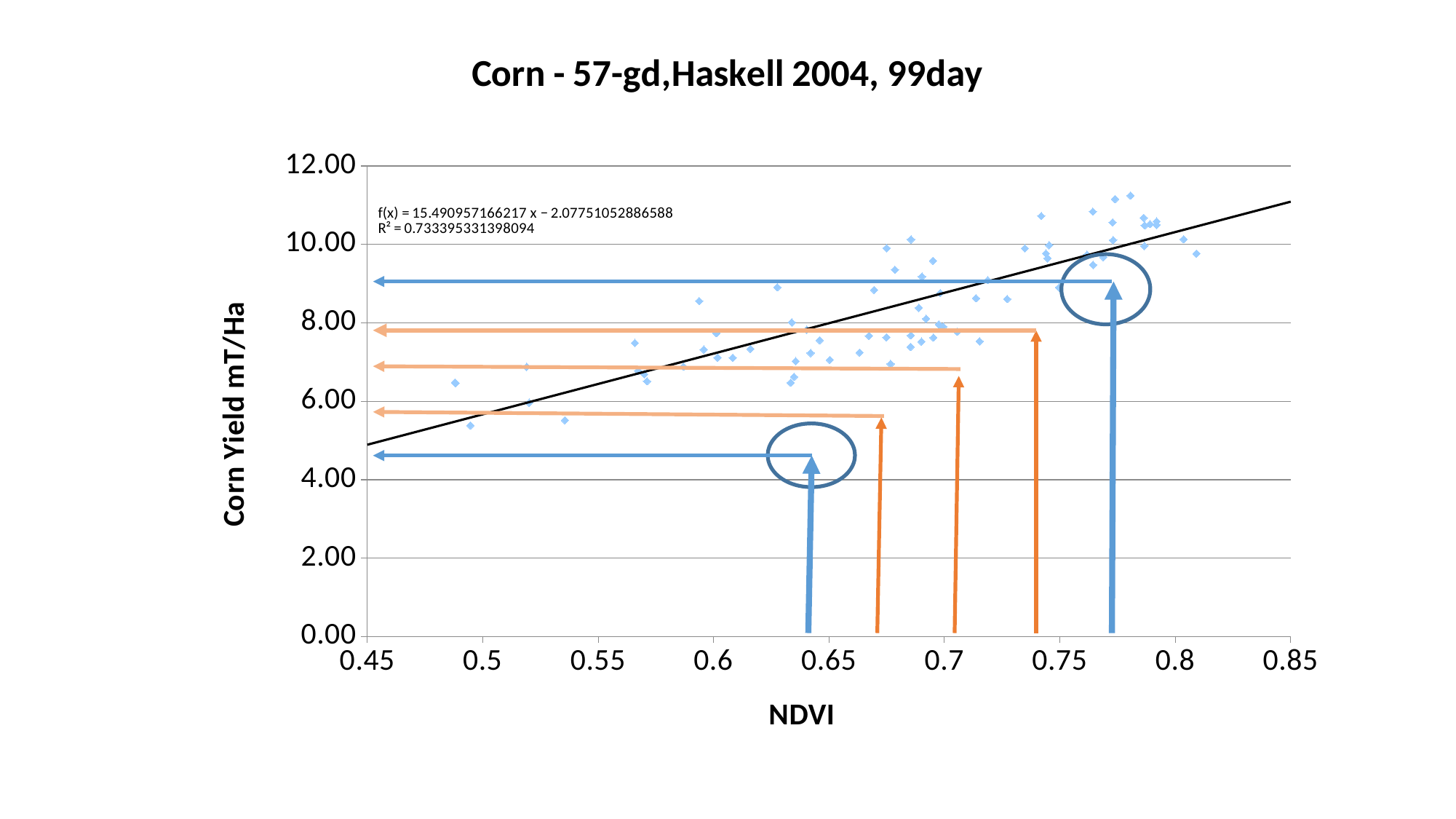
What is the intercept of the fitted line f(x) printed on the chart? −2.07751052886588 What is the slope of the fitted line f(x) printed on the chart? 15.490957166217 What kind of chart is shown on the slide? scatter chart What is the highest value shown on the y axis? 12.00 What is the R² value printed on the chart? 0.733395331398094 What is the label of the y axis? Corn Yield mT/Ha What is the highest NDVI value shown on the x axis? 0.85 What is the lowest NDVI value shown on the x axis? 0.45 Is the fitted line's value at NDVI 0.45 greater or less than 6.00? less Does corn yield rise or fall as NDVI increases along the x axis? rise Is the fitted line's value at NDVI 0.85 greater or less than 10.00? greater What is the title of the chart? Corn - 57-gd,Haskell 2004, 99day